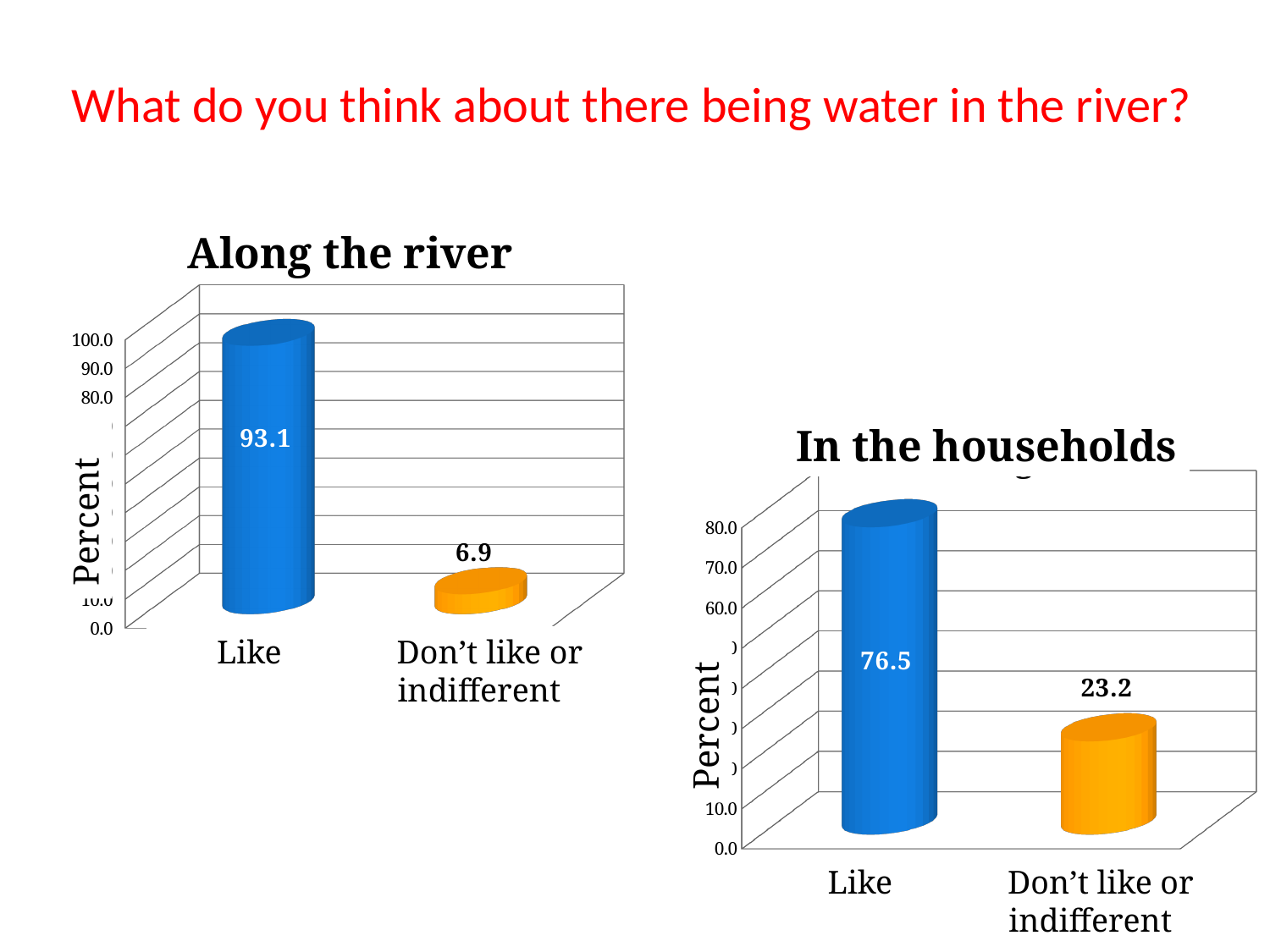
In the 'Along the river' chart, what is the difference between the values for Like and Don't like or indifferent? 86.2 In the 'Along the river' chart, what is the value for Like? 93.1 In the 'Along the river' chart, what is the value for Don't like or indifferent? 6.9 How many categories are shown in the 'Along the river' chart? 2 In the 'In the households' chart, what is the value for Don't like or indifferent? 23.2 In the 'In the households' chart, is the value for Like greater or less than 70.0? greater Which chart has the larger value for Like, 'Along the river' or 'In the households'? Along the river What kind of chart is the 'In the households' chart? Bar chart In the 'In the households' chart, which category has the lowest value? Don't like or indifferent In the 'In the households' chart, what is the difference between the values for Like and Don't like or indifferent? 53.3 In the 'Along the river' chart, which category has the highest value? Like In the 'In the households' chart, what is the value for Like? 76.5